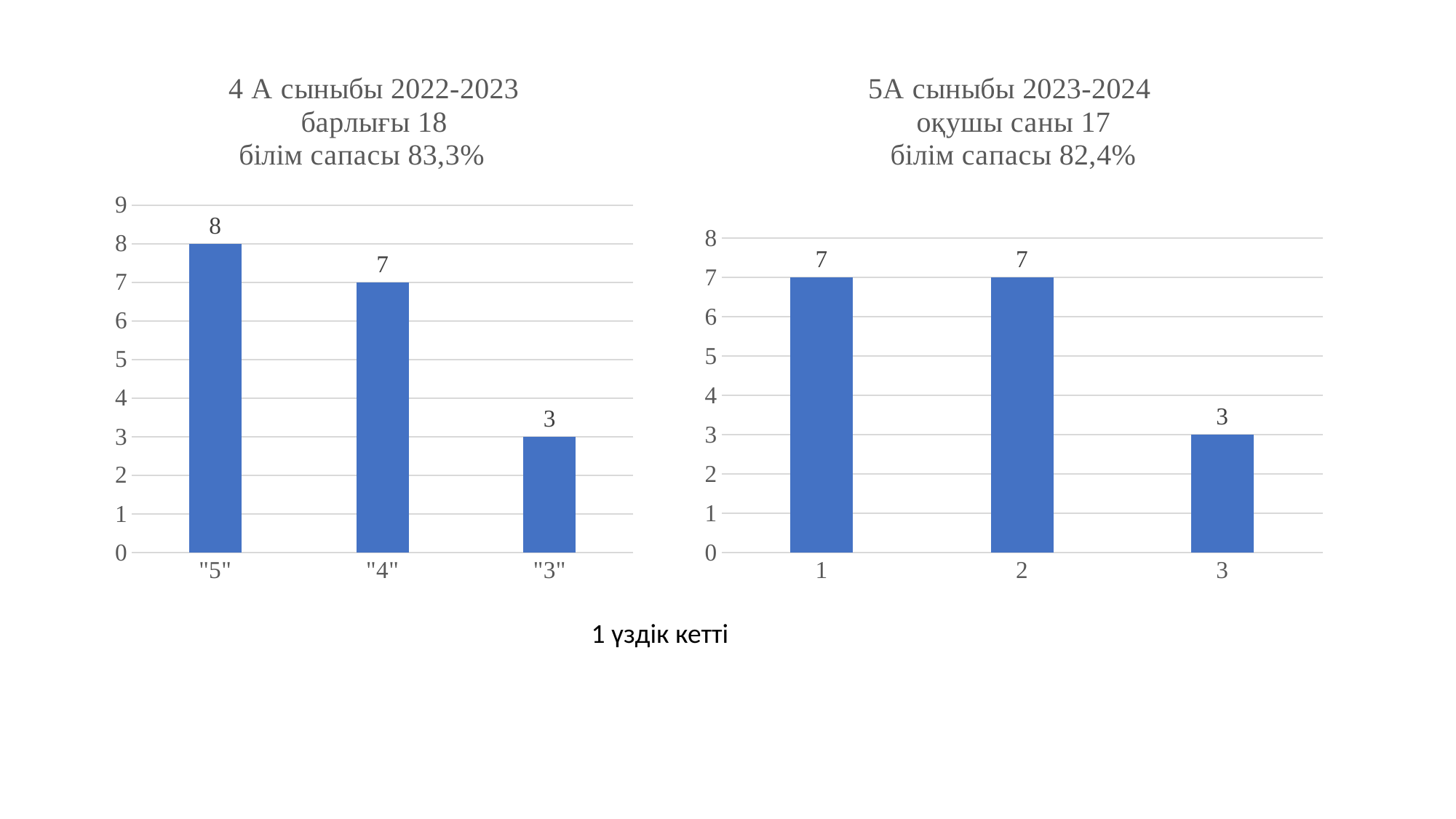
In the right chart (5А сыныбы 2023-2024), what is the value for category 3? 3 In the left chart (4 А сыныбы 2022-2023), what is the value for "3"? 3 In the right chart (5А сыныбы 2023-2024), what is the value for category 2? 7 In the left chart (4 А сыныбы 2022-2023), which category has the highest value? "5" In the left chart (4 А сыныбы 2022-2023), which category has the lowest value? "3" In the left chart (4 А сыныбы 2022-2023), how many categories are shown on the x axis? 3 In the right chart (5А сыныбы 2023-2024), what is the difference between the values for category 1 and category 3? 4 In the left chart (4 А сыныбы 2022-2023), do the values rise or fall from left to right along the x axis? fall In the right chart (5А сыныбы 2023-2024), which category has the lowest value? 3 In the left chart (4 А сыныбы 2022-2023), what is the value for "5"? 8 What kind of chart is the right chart (5А сыныбы 2023-2024)? bar chart In the left chart (4 А сыныбы 2022-2023), what is the difference between the values for "5" and "3"? 5